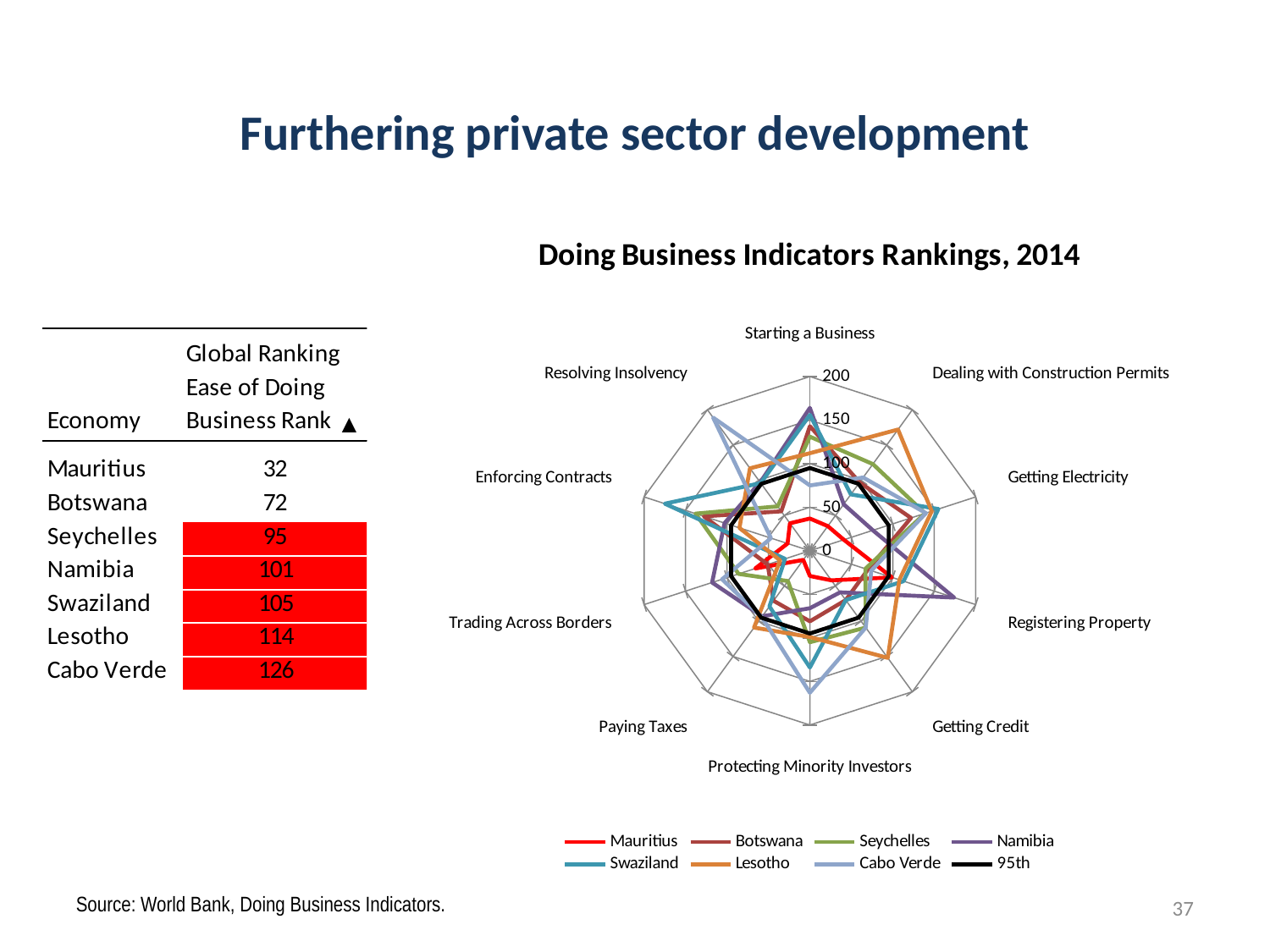
Which series has the lowest value on Starting a Business, Mauritius or Cabo Verde? Mauritius Is the value for Cabo Verde on Resolving Insolvency greater or less than 150? greater Is the value for Swaziland on Enforcing Contracts greater or less than 150? greater What is the title of the chart? Doing Business Indicators Rankings, 2014 What kind of chart is shown on the slide? Radar chart Which series is drawn in black on the chart? 95th How many indicator categories (axes) does the radar chart have? 10 Is the value for Mauritius on Starting a Business greater or less than 50? less How many series does the chart legend list? 8